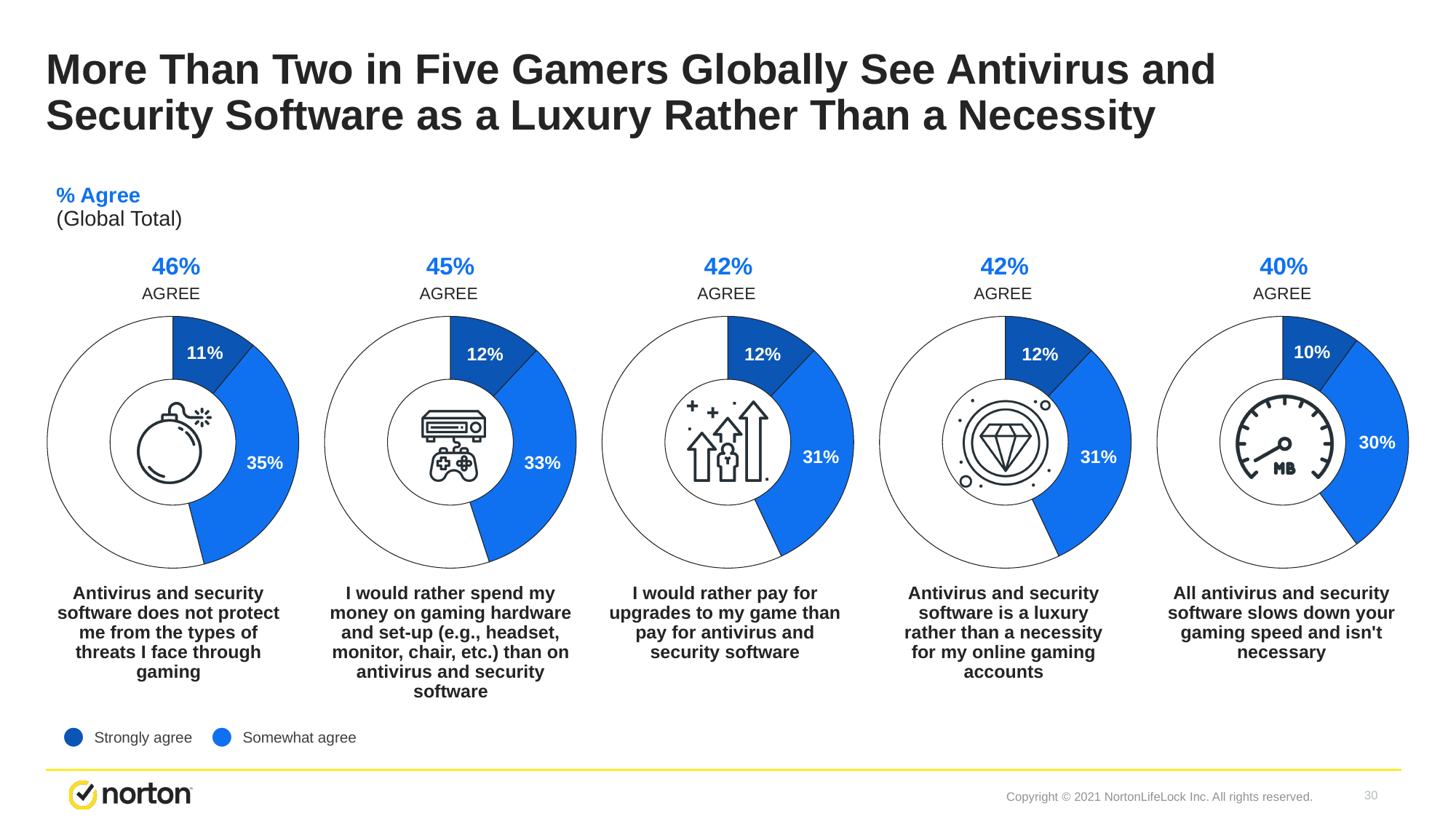
What type of chart is used on this slide? Donut (pie) chart In the middle donut chart (rather pay for game upgrades), what percentage somewhat agree? 31% In the leftmost donut chart (antivirus does not protect me from gaming threats), what percentage strongly agree? 11% In the fourth donut chart (antivirus is a luxury rather than a necessity), which is larger: strongly agree or somewhat agree? Somewhat agree Which statement has the highest total agree percentage? Antivirus and security software does not protect me from the types of threats I face through gaming What is the difference between the total agree percentage for the leftmost chart and the rightmost chart? 6% How many series does the legend list? 2 Which statement has the lowest total agree percentage? All antivirus and security software slows down your gaming speed and isn't necessary How many donut charts are shown on the slide? 5 What are the two legend entries on the slide? Strongly agree, Somewhat agree In the rightmost donut chart (antivirus slows down gaming speed), what percentage somewhat agree? 30% In the second donut chart from the left (rather spend money on gaming hardware), what is the total percentage that agree? 45%